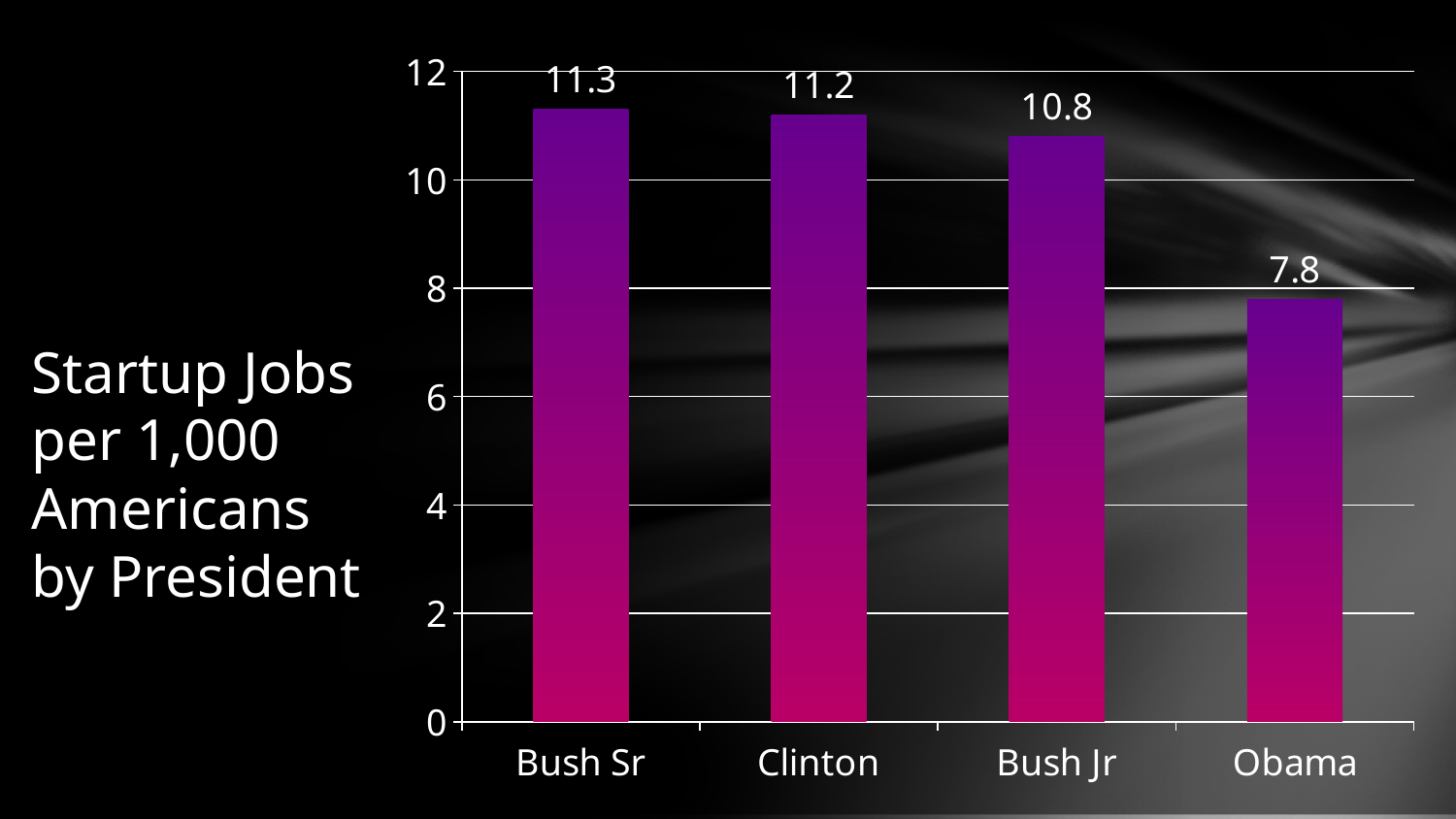
What is the value for Obama? 7.8 What is the value for Bush Jr? 10.8 What is the value for Clinton? 11.2 Is the value for Obama greater or less than 8? less Which is larger, the value for Bush Jr or the value for Obama? Bush Jr What is the value for Bush Sr? 11.3 What kind of chart is shown on the slide? bar chart Do the values rise or fall from Bush Sr to Obama along the x axis? fall What is the difference between the values for Bush Sr and Obama? 3.5 How many presidents are shown on the chart? 4 Which president has the lowest value? Obama What is the difference between the values for Clinton and Bush Jr? 0.4